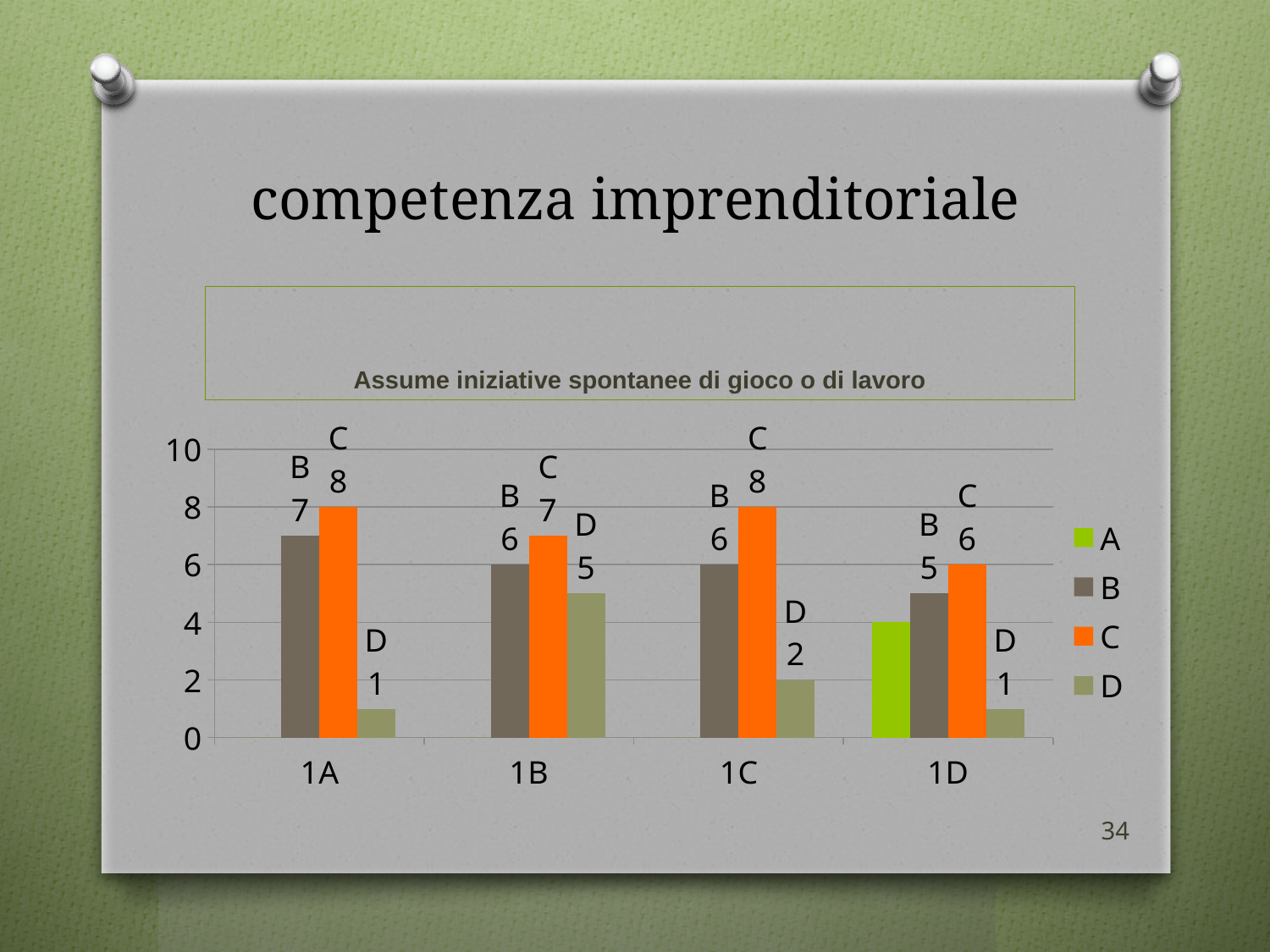
Is the value of series A for category 1D greater or less than 2? greater How many categories are shown on the x axis? 4 What kind of chart is shown on the slide? bar chart What is the difference between series C and series B for category 1C? 2 What is the value of series B for category 1D? 5 What is the title of the chart? Assume iniziative spontanee di gioco o di lavoro How many series does the legend list? 4 Which category has the lowest value for series C? 1D Which is larger for category 1B: series B or series C? C What is the value of series C for category 1A? 8 Which category has the highest value for series D? 1B What is the value of series D for category 1B? 5